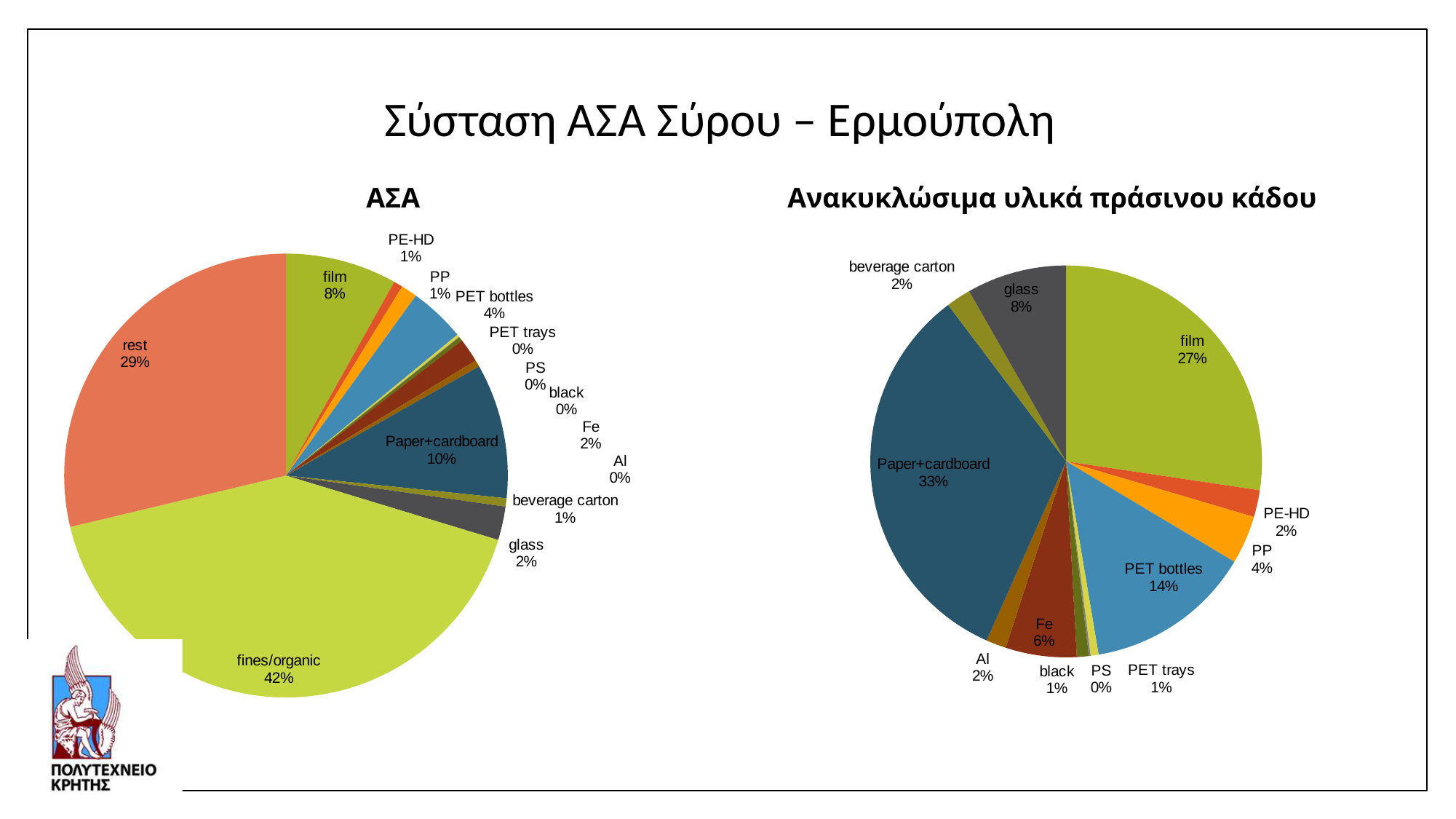
In the Ανακυκλώσιμα υλικά πράσινου κάδου pie chart, what is the share of PET bottles? 14% In the ΑΣΑ pie chart, how many categories are shown? 14 In the Ανακυκλώσιμα υλικά πράσινου κάδου pie chart, which is larger: glass or Fe? glass What type of chart is used on the slide? pie chart In the ΑΣΑ pie chart, what share does fines/organic have? 42% What is the title of the right-hand chart? Ανακυκλώσιμα υλικά πράσινου κάδου In the Ανακυκλώσιμα υλικά πράσινου κάδου pie chart, which category has the largest share? Paper+cardboard In the ΑΣΑ pie chart, what is the share of Paper+cardboard? 10% In the ΑΣΑ pie chart, what is the difference between the shares of rest and film? 21% In the ΑΣΑ pie chart, which category has the largest share? fines/organic In the Ανακυκλώσιμα υλικά πράσινου κάδου pie chart, what is the difference between the shares of Paper+cardboard and film? 6%